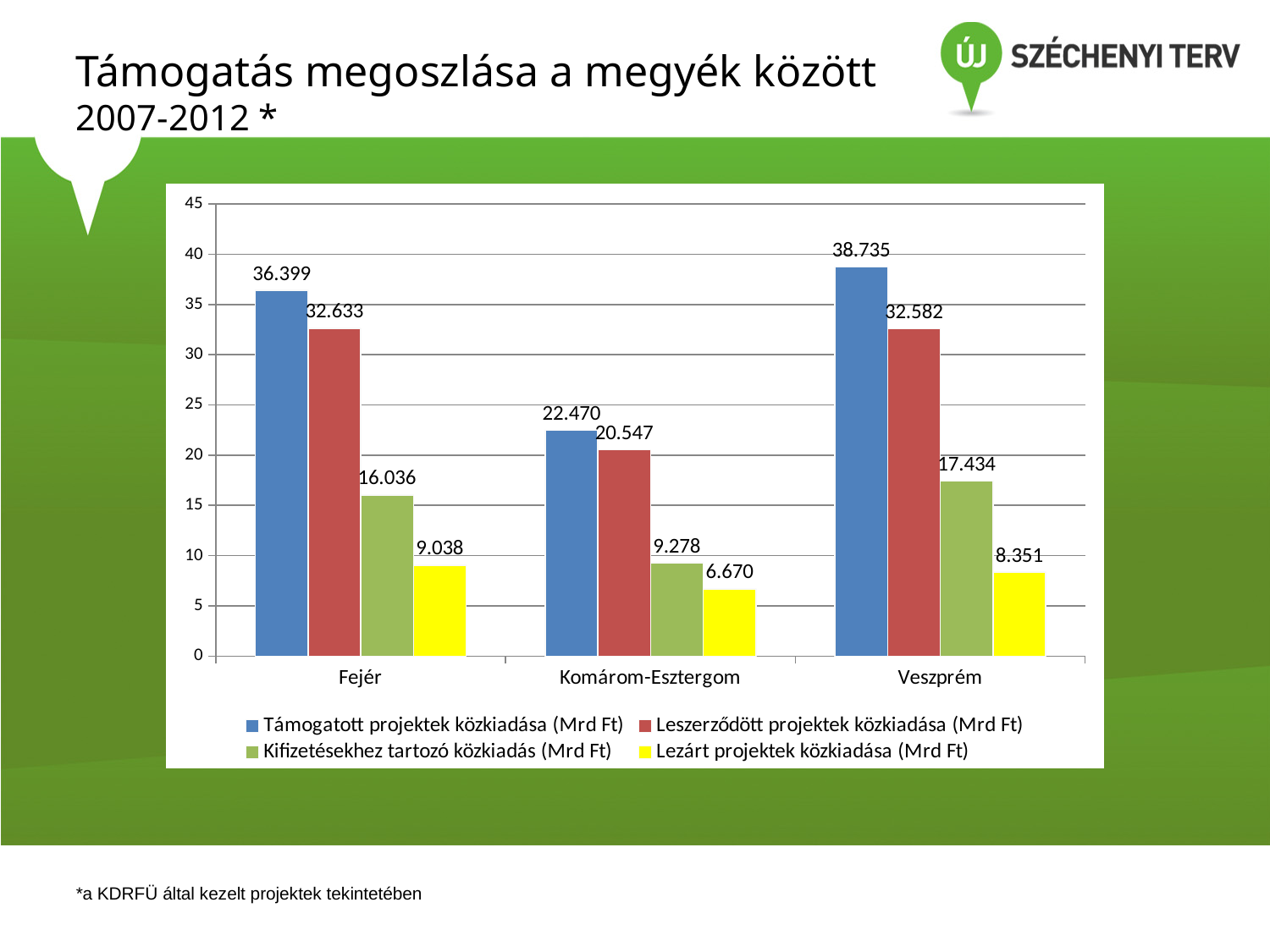
How many series does the legend list? 4 What type of chart is shown on the slide? bar chart Is the value of Leszerződött projektek közkiadása (Mrd Ft) for Komárom-Esztergom greater or less than 25? less What is the difference between Támogatott projektek közkiadása (Mrd Ft) for Veszprém and for Fejér? 2.336 What is the value of Támogatott projektek közkiadása (Mrd Ft) for Veszprém? 38.735 How many counties (categories) are shown on the x axis? 3 What is the value of Kifizetésekhez tartozó közkiadás (Mrd Ft) for Fejér? 16.036 Which county has the highest value for Támogatott projektek közkiadása (Mrd Ft)? Veszprém Which is larger: Kifizetésekhez tartozó közkiadás (Mrd Ft) for Veszprém or for Fejér? Veszprém What is the value of Lezárt projektek közkiadása (Mrd Ft) for Komárom-Esztergom? 6.670 Which county has the lowest value for Lezárt projektek közkiadása (Mrd Ft)? Komárom-Esztergom What colour are the bars for Lezárt projektek közkiadása (Mrd Ft)? yellow